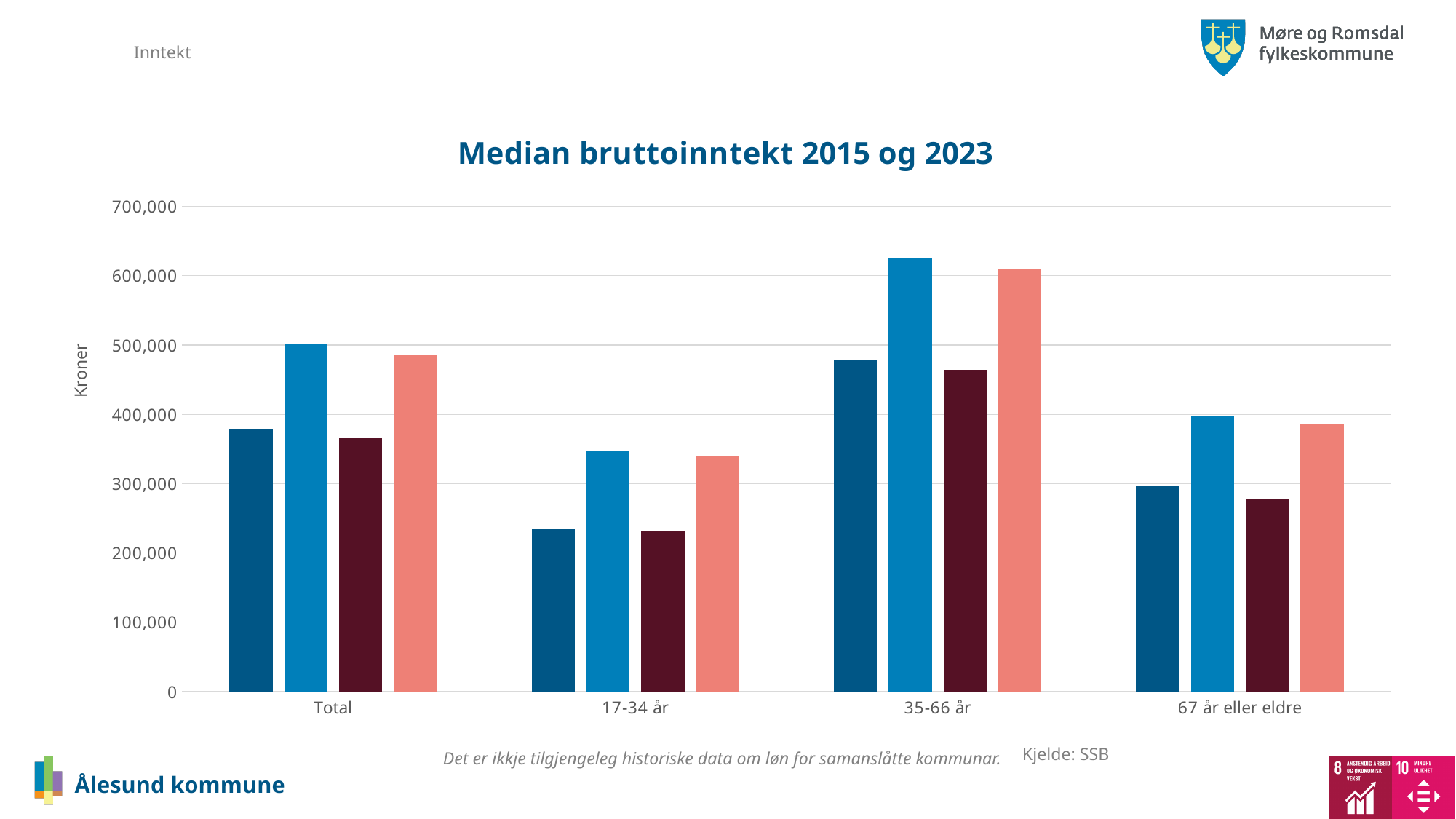
What kind of chart is shown on the slide? bar chart Which category has the tallest bars overall? 35-66 år Is the value of the salmon bar for 17-34 år greater or less than 300,000? greater How many bars are plotted for each category? 4 Is the value of the dark blue bar for Total greater or less than 400,000? less How many age categories are shown along the x axis? 4 Is the value of the light blue bar for 35-66 år greater or less than 600,000? greater What is the title of the chart? Median bruttoinntekt 2015 og 2023 What is the label on the vertical axis of the chart? Kroner In the Total category, which is larger: the light blue bar or the dark red bar? the light blue bar Which category has the shortest bars overall? 17-34 år